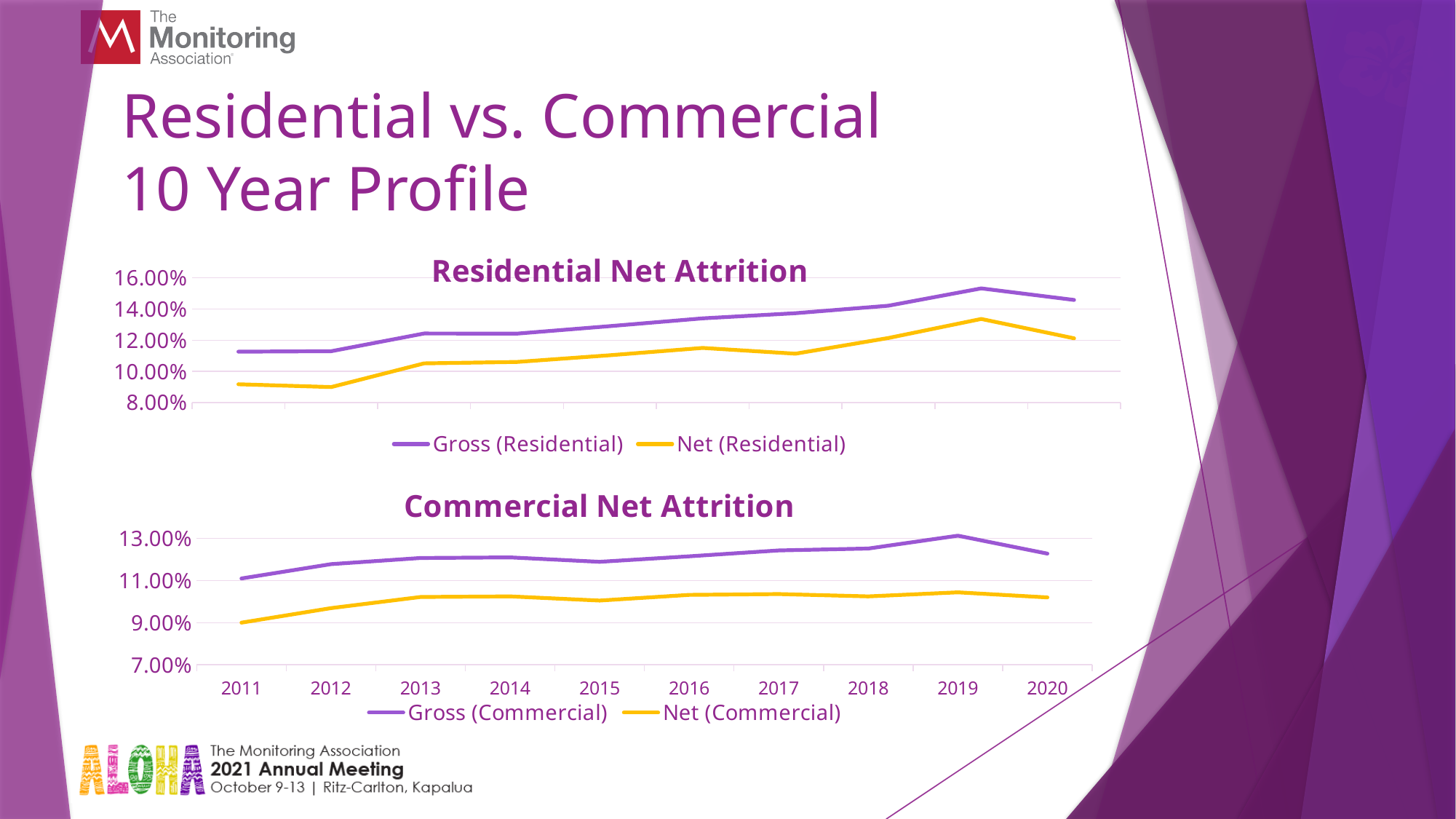
On the Commercial Net Attrition chart, is the value for Net (Commercial) in 2015 greater or less than 11.00%? less What are the two legend entries on the Residential Net Attrition chart? Gross (Residential) and Net (Residential) On the Commercial Net Attrition chart, which is larger in 2020, Gross (Commercial) or Net (Commercial)? Gross (Commercial) On the Residential Net Attrition chart, is the first point of the Net (Residential) line greater or less than 10.00%? less How many series does the legend of the Residential Net Attrition chart list? 2 On the Commercial Net Attrition chart, is the value for Gross (Commercial) in 2015 greater or less than 11.00%? greater On the Commercial Net Attrition chart, how many years are shown on the x axis? 10 On the Commercial Net Attrition chart, in which year is Gross (Commercial) highest? 2019 On the Commercial Net Attrition chart, in which year is Net (Commercial) lowest? 2011 On the Residential Net Attrition chart, does the Gross (Residential) line generally rise or fall from its first point to its last point? Rise What kind of chart is the Residential Net Attrition chart? Line chart On the Commercial Net Attrition chart, in which year is Gross (Commercial) lowest? 2011